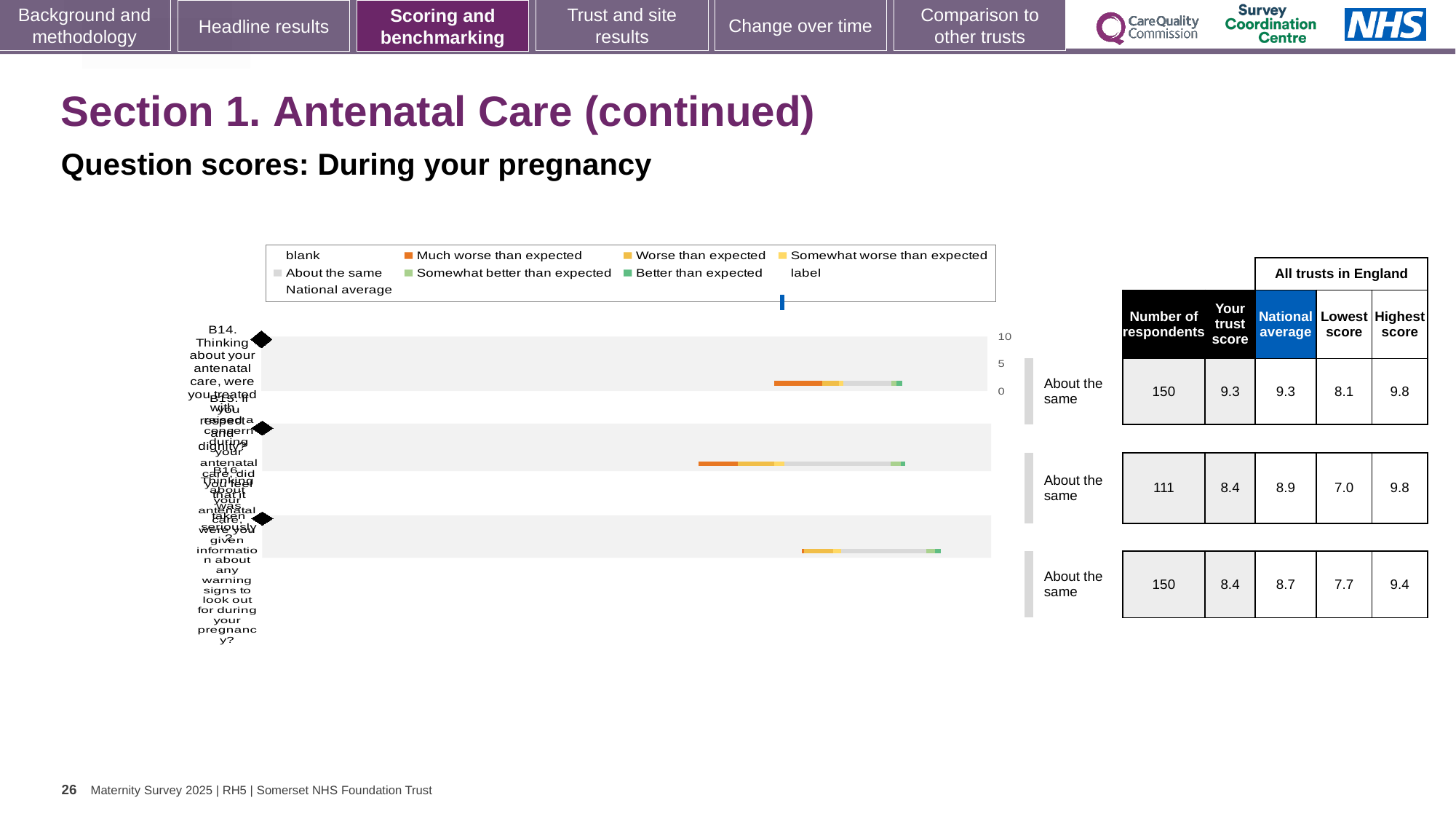
What is the trust score for question B14 (treated with respect and dignity)? 9.3 How many respondents answered question B14? 150 How many questions are plotted in the chart? 3 What is the difference between the national average and the trust score for the second question in the chart? 0.5 Which question has the highest trust score? B14 What benchmark category is shown for question B14? About the same What is the national average for question B14? 9.3 How many respondents answered the second question in the chart? 111 For the third question in the chart, which is larger: the trust score or the national average? national average What is the highest score across all trusts in England for question B14? 9.8 What is the lowest score across all trusts in England for question B14? 8.1 What kind of chart is shown on the slide? bar chart